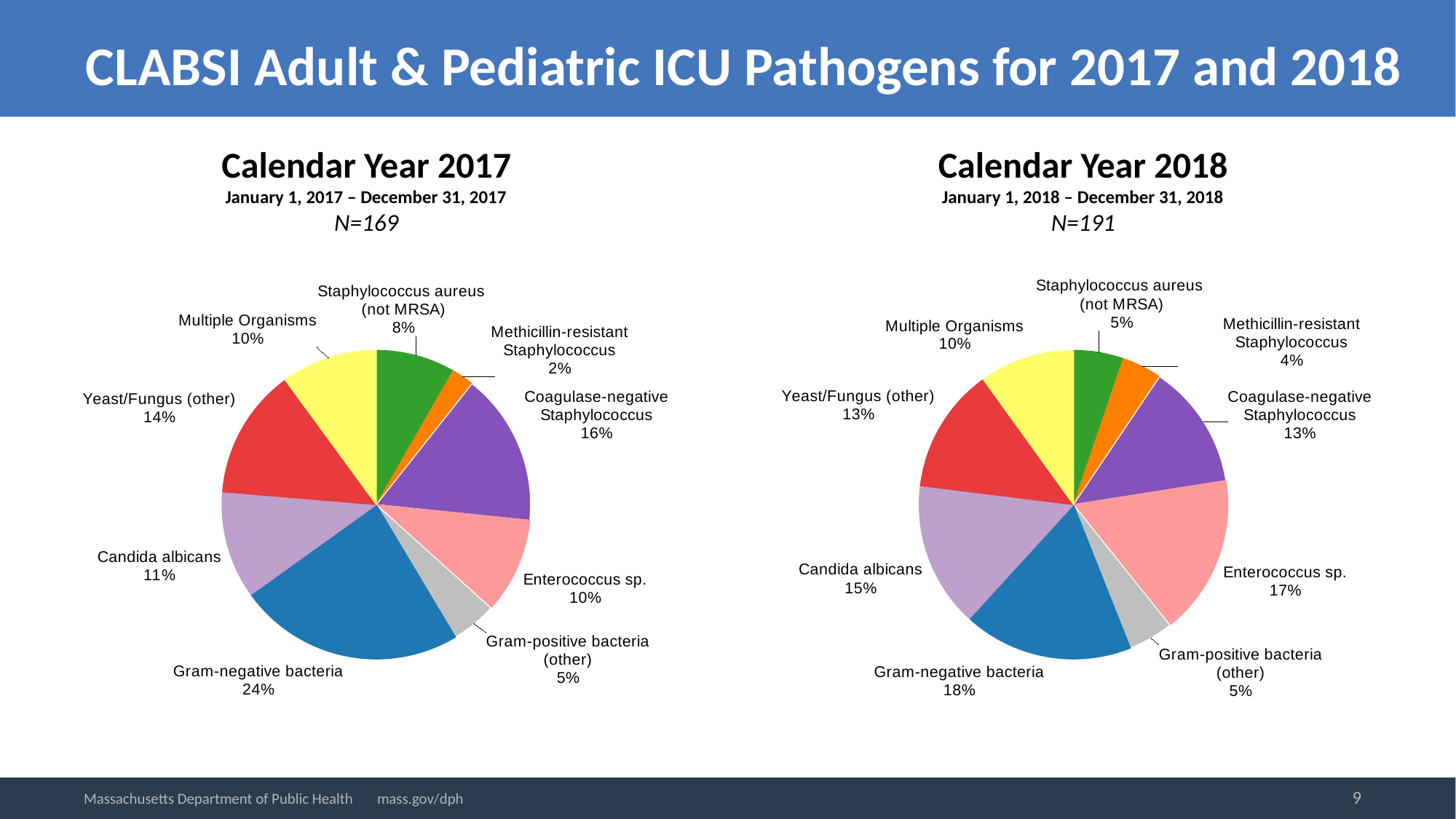
In the Calendar Year 2018 pie chart, which pathogen category has the largest share? Gram-negative bacteria In the Calendar Year 2018 pie chart, which is larger: the share for Candida albicans or the share for Yeast/Fungus (other)? Candida albicans In the Calendar Year 2017 pie chart, what share does Gram-negative bacteria have? 24% How many pathogen categories are shown in the Calendar Year 2017 pie chart? 10 What is the N value shown for the Calendar Year 2018 chart? N=191 In the Calendar Year 2018 pie chart, what share does Enterococcus sp. have? 17% In the Calendar Year 2018 pie chart, which pathogen category has the smallest share? Methicillin-resistant Staphylococcus In the Calendar Year 2017 pie chart, which pathogen category has the largest share? Gram-negative bacteria In the Calendar Year 2017 pie chart, what share does Coagulase-negative Staphylococcus have? 16% What type of chart is used for the Calendar Year 2018 data? Pie chart In the Calendar Year 2017 pie chart, which pathogen category has the smallest share? Methicillin-resistant Staphylococcus What is the difference between the Gram-negative bacteria share in the Calendar Year 2017 chart and in the Calendar Year 2018 chart? 6 percentage points